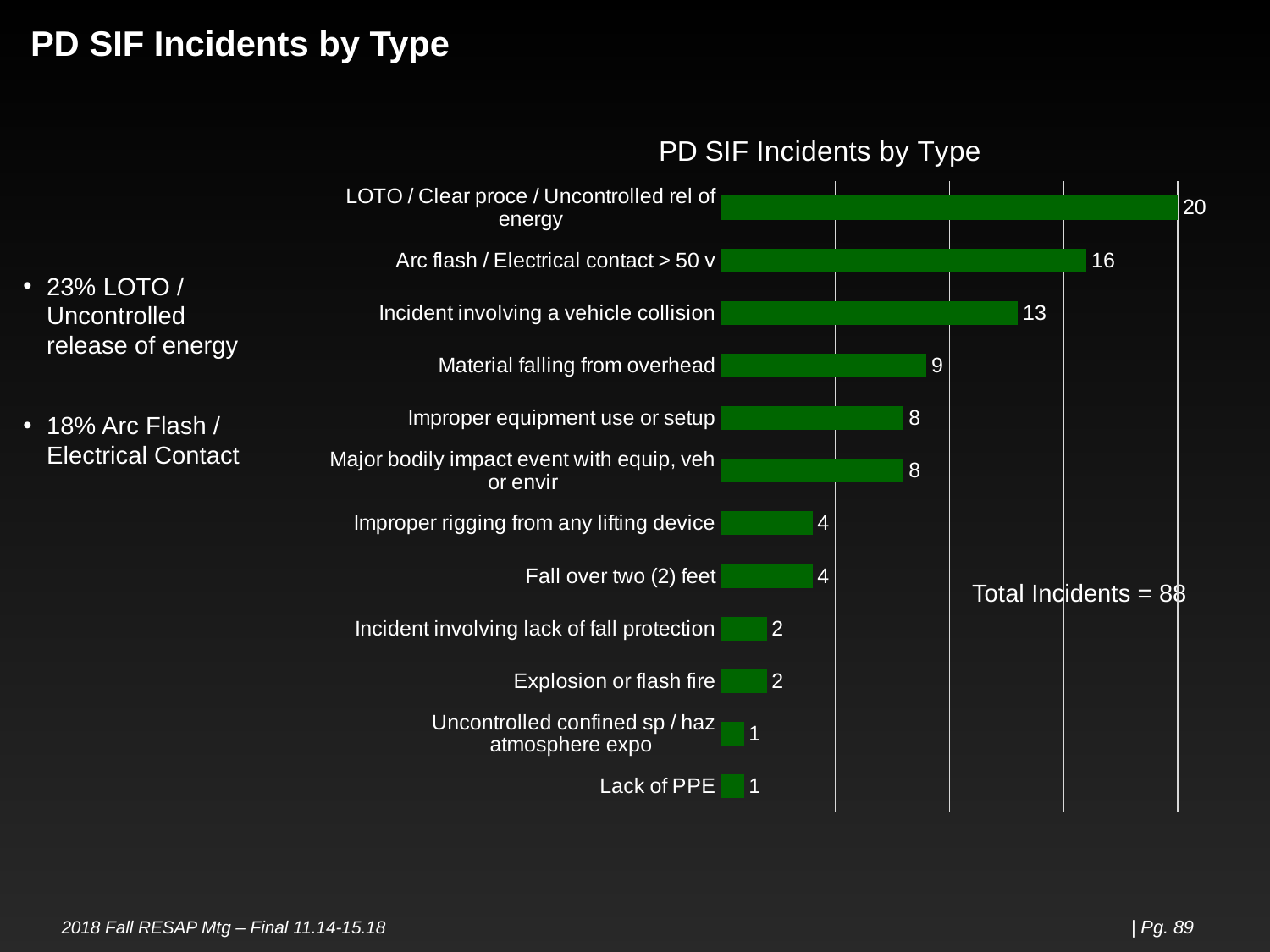
What is the title of the chart? PD SIF Incidents by Type What is the value for Arc flash / Electrical contact > 50 v? 16 What is the difference between the values for LOTO / Clear proce / Uncontrolled rel of energy and Arc flash / Electrical contact > 50 v? 4 Which is larger: Improper equipment use or setup or Improper rigging from any lifting device? Improper equipment use or setup What kind of chart is shown? bar chart What is the value for Explosion or flash fire? 2 What is the value for Material falling from overhead? 9 What is the value for Incident involving a vehicle collision? 13 Which category has the highest value? LOTO / Clear proce / Uncontrolled rel of energy What total number of incidents is stated on the chart? 88 How many categories are shown in the chart? 12 What is the difference between the values for Incident involving a vehicle collision and Material falling from overhead? 4